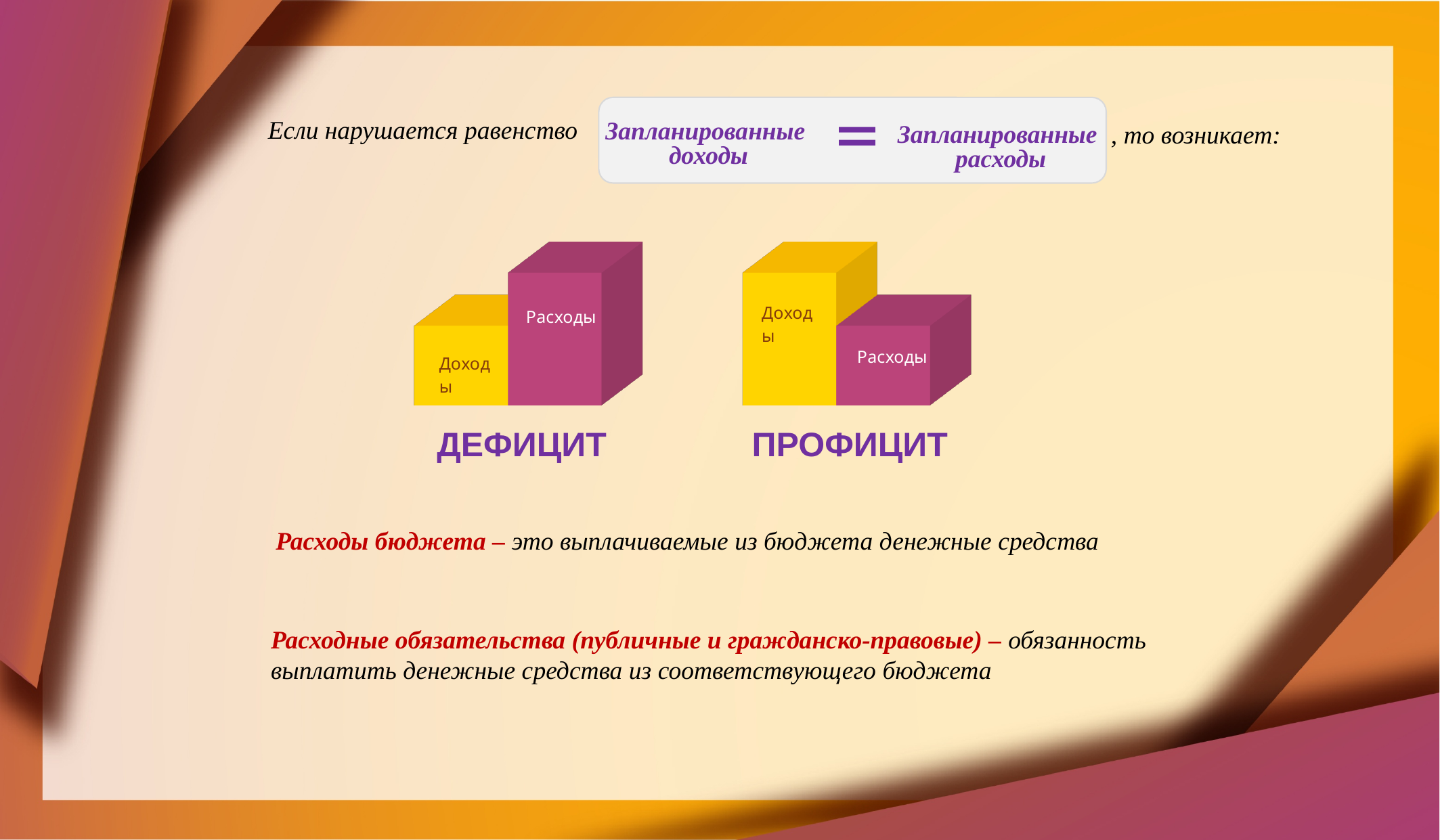
What kind of chart is shown under the label ПРОФИЦИТ? bar chart In the ПРОФИЦИТ chart, which category has the lowest bar? Расходы In the ДЕФИЦИТ chart, which category has the lowest bar? Доходы In the ПРОФИЦИТ chart, which category has the highest bar? Доходы In the ПРОФИЦИТ chart, what colour is the Расходы bar? magenta In the ДЕФИЦИТ chart, which category has the highest bar? Расходы In the ПРОФИЦИТ chart, which bar is taller, Доходы or Расходы? Доходы In the ДЕФИЦИТ chart, which bar is taller, Доходы or Расходы? Расходы What kind of chart is shown under the label ДЕФИЦИТ? bar chart In the ДЕФИЦИТ chart, how many bars are there? 2 In the ПРОФИЦИТ chart, how many bars are there? 2 In the ДЕФИЦИТ chart, what colour is the Доходы bar? yellow